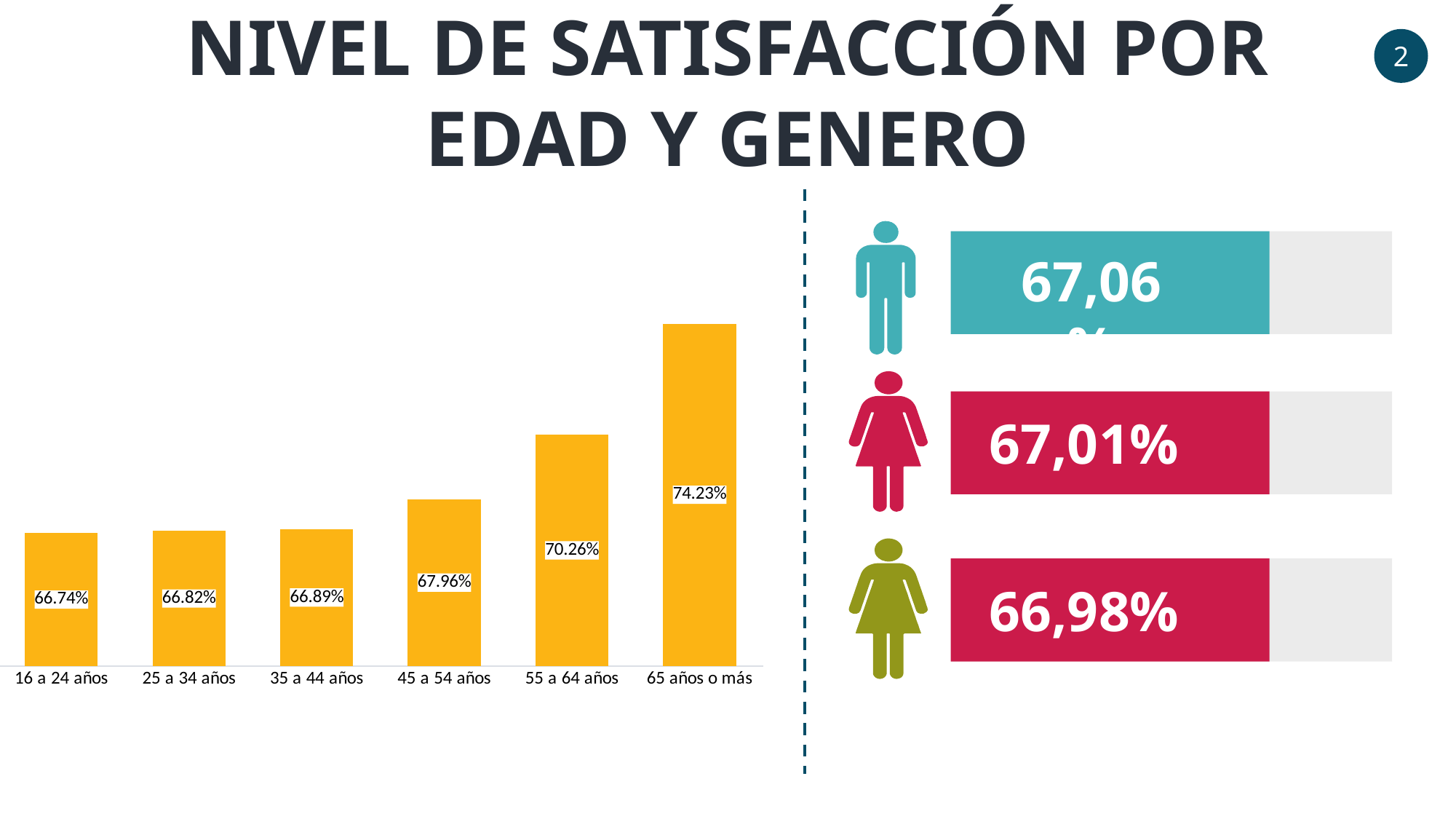
In the bar chart on the left, which age group has the lowest satisfaction level? 16 a 24 años In the bar chart on the left, what is the difference between the values for 65 años o más and 55 a 64 años? 3.97% In the bar chart on the left, which is larger: the value for 45 a 54 años or the value for 35 a 44 años? 45 a 54 años In the bar chart on the left, what is the value for 65 años o más? 74.23% In the bar chart on the left, what is the satisfaction value for the 16 a 24 años group? 66.74% In the bar chart on the left, do the values rise or fall as the age groups go from youngest to oldest? Rise What kind of chart is shown on the left of the slide? Bar chart In the bar chart on the left, which age group has the highest satisfaction level? 65 años o más In the bar chart on the left, what is the difference between the values for 35 a 44 años and 25 a 34 años? 0.07% In the bar chart on the left, what is the value for 55 a 64 años? 70.26% In the bar chart on the left, what is the value for 45 a 54 años? 67.96% How many age groups are shown in the bar chart on the left? 6